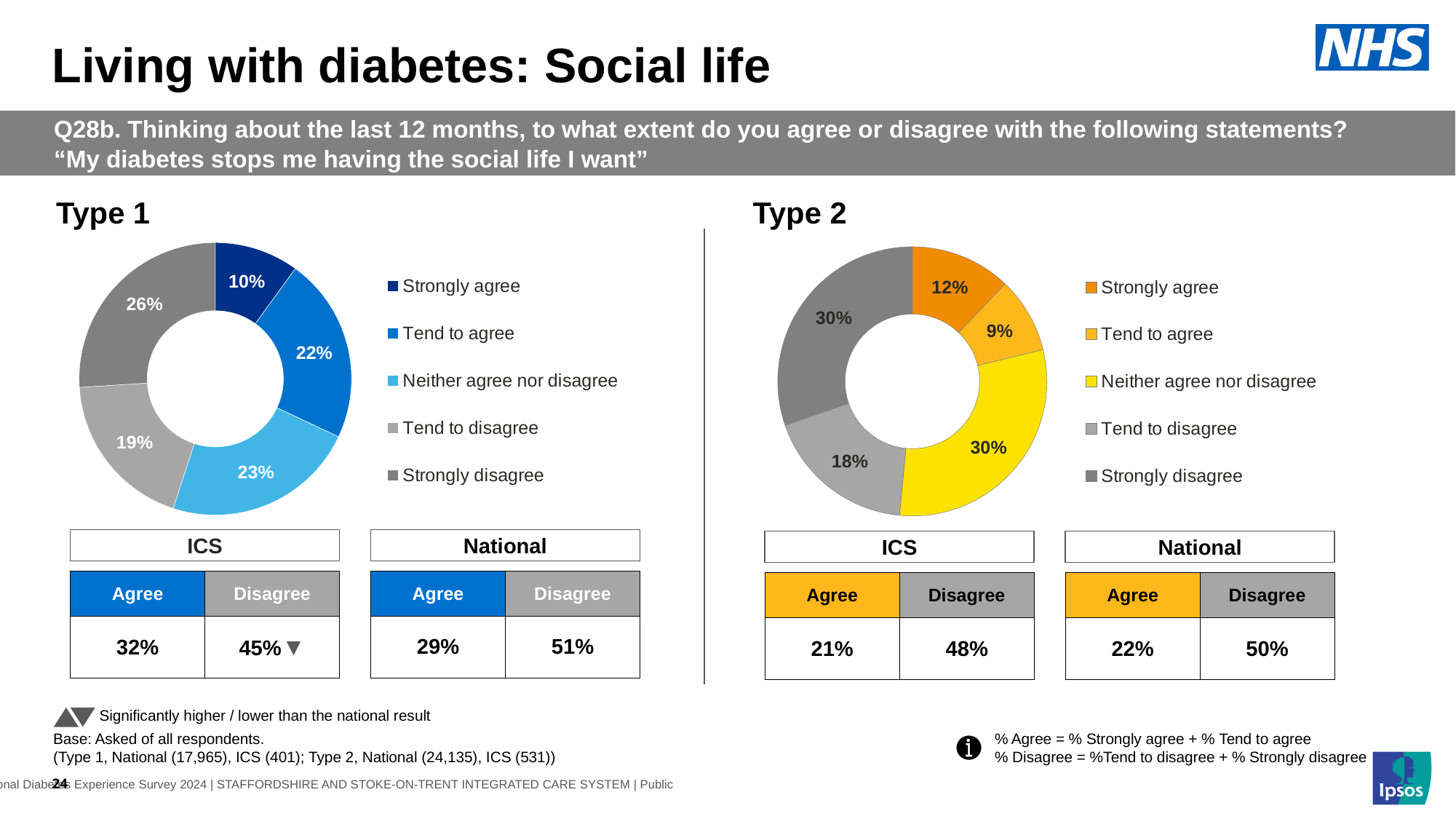
In the Type 1 chart, what percentage of respondents said 'Strongly agree'? 10% In the Type 2 chart, what is the combined share of 'Strongly agree' and 'Tend to agree'? 21% In the Type 2 chart, what percentage of respondents said 'Tend to agree'? 9% What type of chart is used to show the Type 2 responses? Doughnut (pie) chart How many response categories does the Type 1 chart's legend list? 5 In the Type 1 chart, what is the combined share of 'Tend to disagree' and 'Strongly disagree'? 45% In the Type 2 chart, which response category has the smallest share? Tend to agree In the Type 1 chart, what percentage of respondents said 'Tend to disagree'? 19% In the Type 2 chart, what colour is the 'Neither agree nor disagree' segment? Yellow In the Type 1 chart, which response category has the largest share? Strongly disagree In the Type 1 chart, what is the difference between the 'Neither agree nor disagree' share and the 'Strongly agree' share? 13 percentage points In the Type 2 chart, which is larger: 'Strongly disagree' or 'Tend to disagree'? Strongly disagree